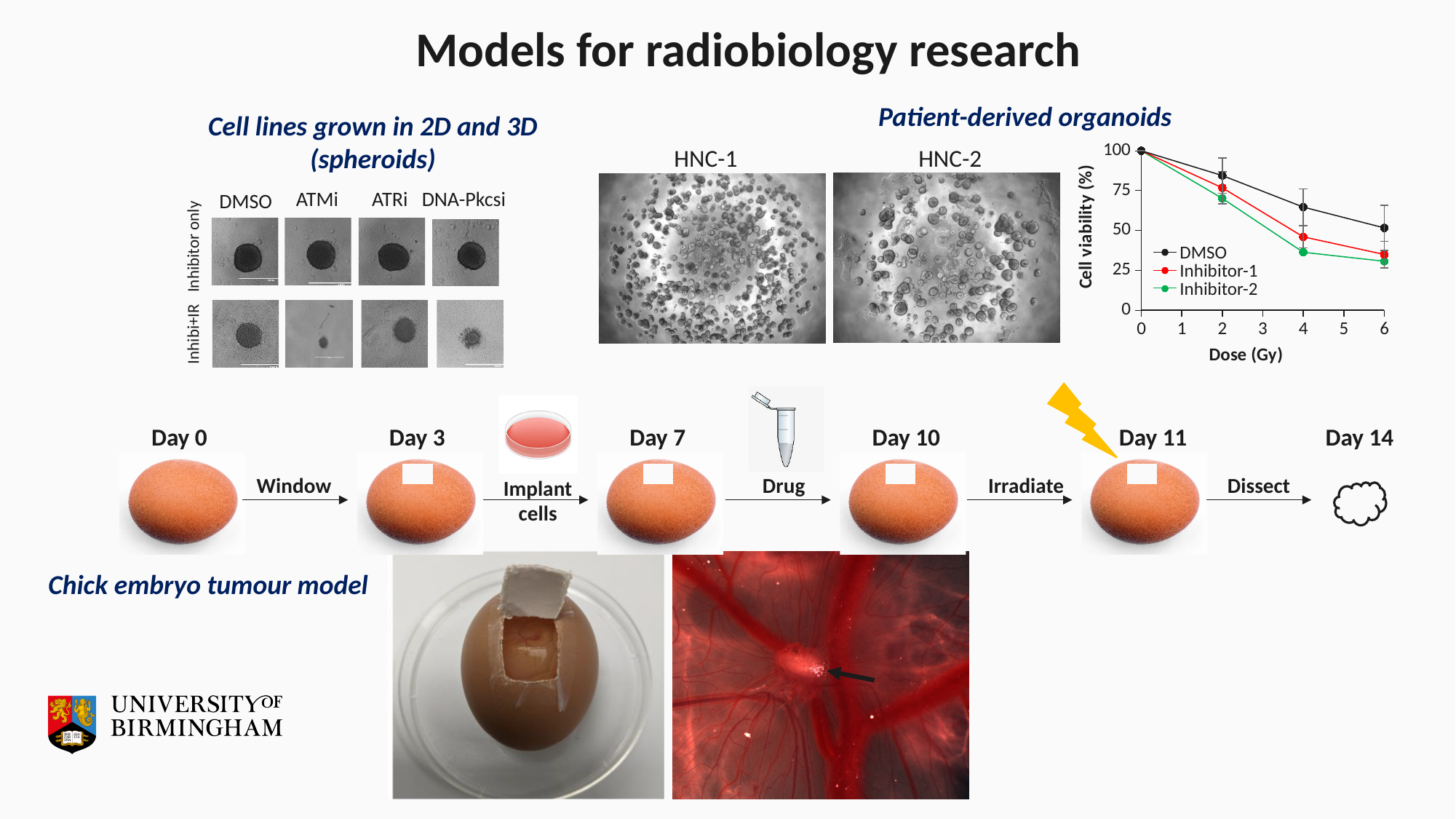
In the cell viability chart, which series has the lowest cell viability at 4 Gy? Inhibitor-2 In the cell viability chart, which series has the highest cell viability at 6 Gy? DMSO In the cell viability chart, what is the cell viability (%) for DMSO at a dose of 0 Gy? 100 In the cell viability chart, which is larger at 4 Gy: the value for DMSO or the value for Inhibitor-2? DMSO What is the label of the x axis of the cell viability chart? Dose (Gy) In the cell viability chart, is the value for DMSO at 2 Gy greater or less than 75? greater In the cell viability chart, is the value for Inhibitor-1 at 2 Gy greater or less than 50? greater What kind of chart is shown under the 'Patient-derived organoids' heading? line chart How many series does the legend of the cell viability chart list? 3 In the cell viability chart, is the value for Inhibitor-2 at 4 Gy greater or less than 50? less In the cell viability chart, does cell viability rise or fall as the dose increases? fall